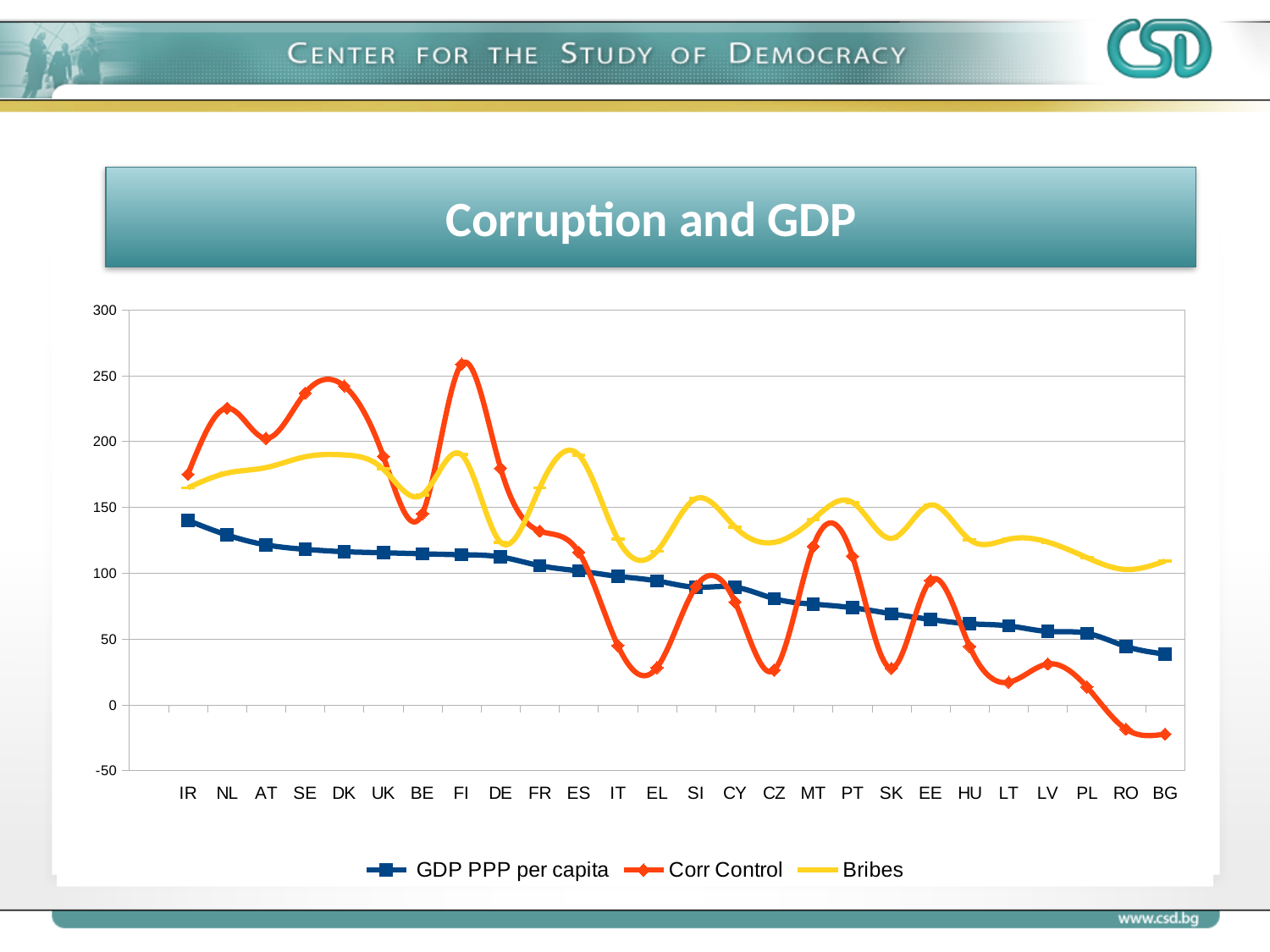
What is the title of the chart? Corruption and GDP Is the Bribes value for IR greater or less than 150? greater Is the Corr Control value for BG greater or less than 0? less What kind of chart is shown on the slide? line chart Which country has the highest GDP PPP per capita value? IR Which country has the highest Corr Control value? FI Which is larger for NL: the Corr Control value or the GDP PPP per capita value? Corr Control How many series does the legend list? 3 Is the Corr Control value for FI greater or less than 250? greater Does the GDP PPP per capita series rise or fall from IR to BG along the x axis? fall How many countries are shown along the x axis? 26 Which country has the lowest GDP PPP per capita value? BG